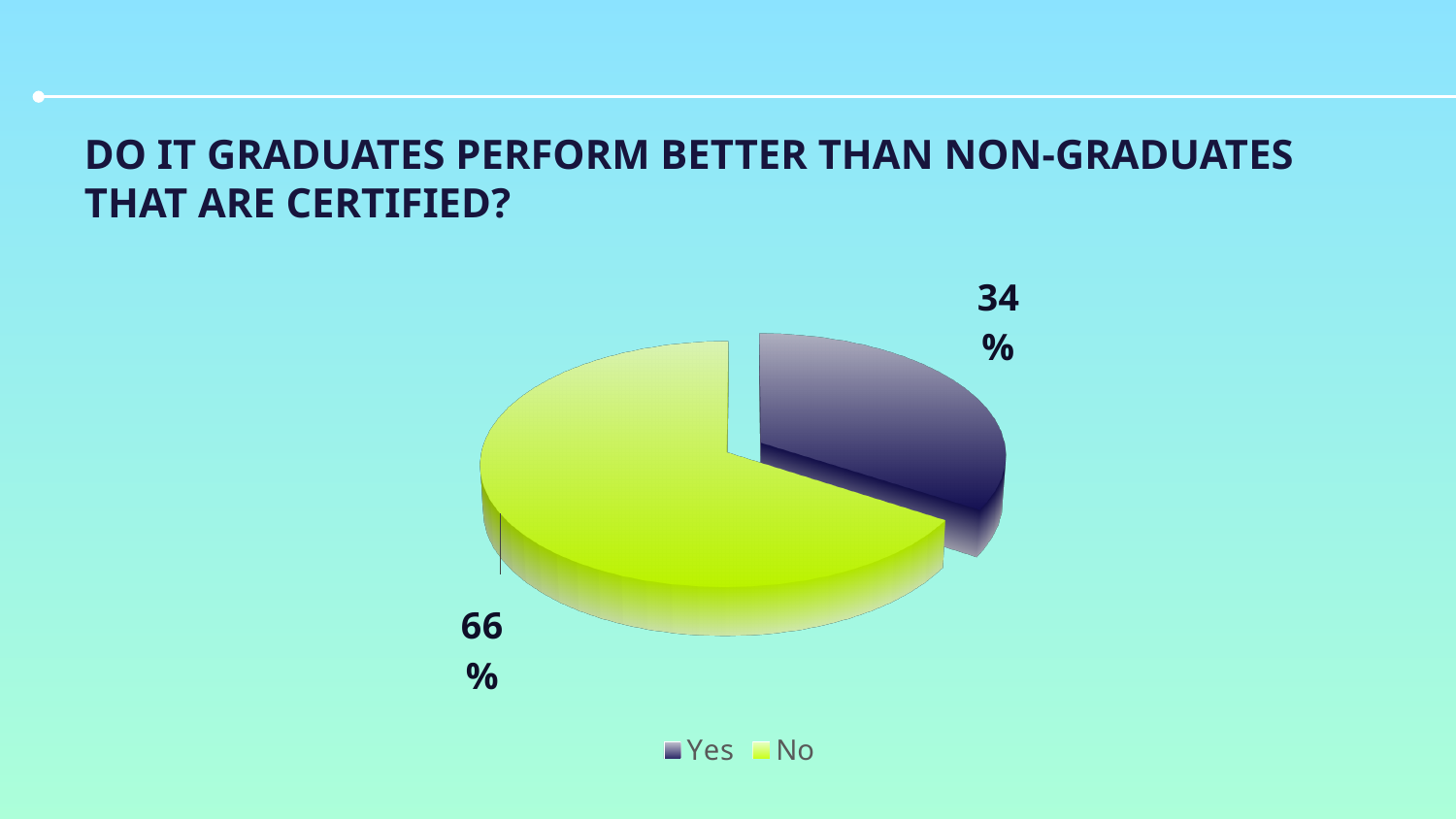
How many slices does the pie chart have? 2 What kind of chart is shown on the slide? pie chart Which response has the smallest share of the pie? Yes What is the title of the slide containing the pie chart? DO IT GRADUATES PERFORM BETTER THAN NON-GRADUATES THAT ARE CERTIFIED? Which is larger, the "Yes" slice or the "No" slice? No What is the difference in percentage points between the "No" and "Yes" slices? 32 Which colour represents "Yes" in the pie chart? dark blue What percentage of responses are "Yes"? 34% What percentage of responses are "No"? 66% What share of the pie does the "No" slice represent? 66% Which response has the largest share of the pie? No How many entries does the legend list? 2